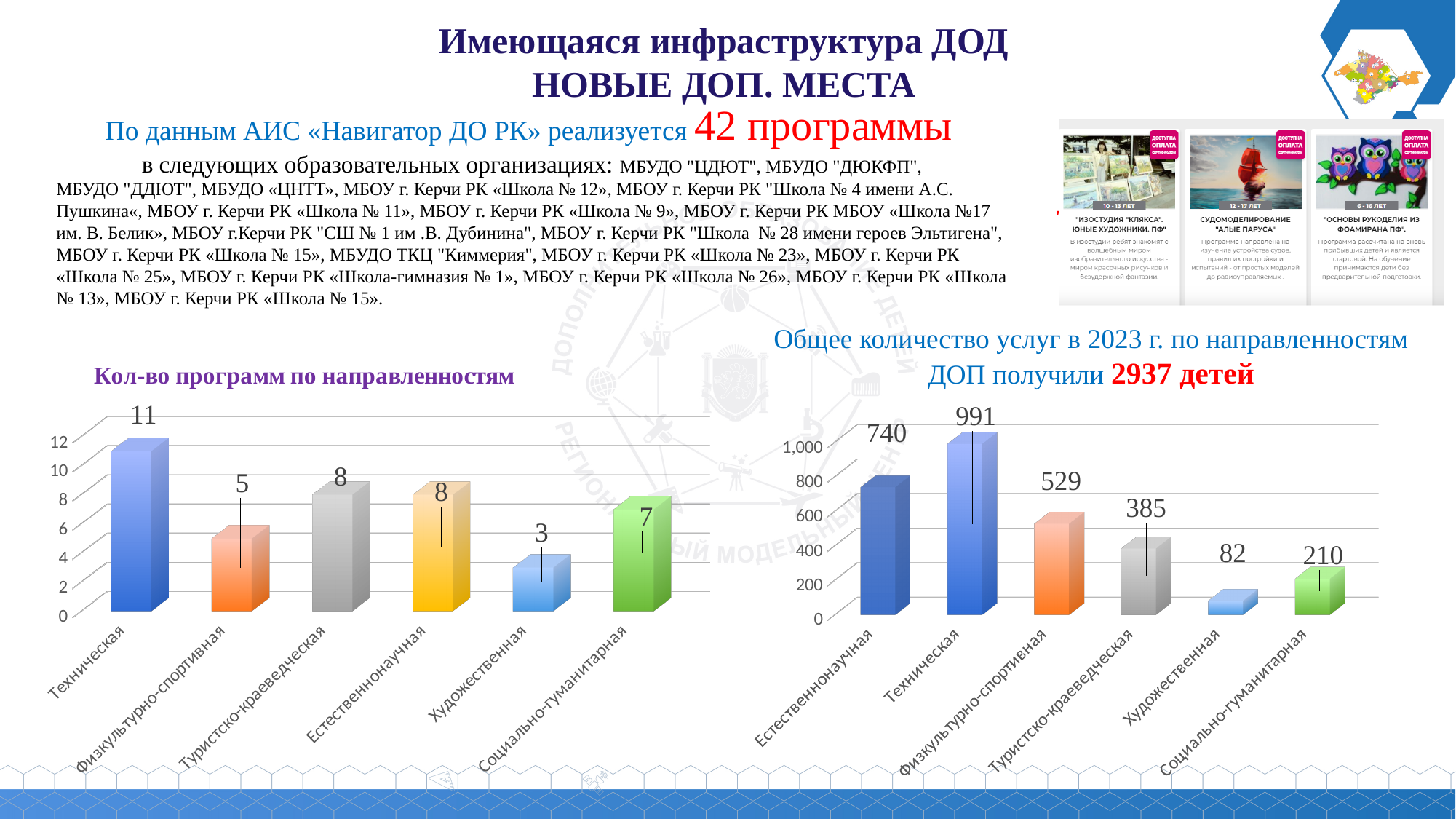
In the left chart 'Кол-во программ по направленностям', how many categories are shown? 6 In the right chart 'Общее количество услуг в 2023 г. по направленностям', which category has the highest value? Техническая In the right chart 'Общее количество услуг в 2023 г. по направленностям', which is larger: Естественнонаучная or Физкультурно-спортивная? Естественнонаучная In the right chart 'Общее количество услуг в 2023 г. по направленностям', what is the difference between Техническая and Художественная? 909 In the left chart 'Кол-во программ по направленностям', what is the difference between Техническая and Физкультурно-спортивная? 6 In the right chart 'Общее количество услуг в 2023 г. по направленностям', is the value for Социально-гуманитарная greater or less than 400? less In the right chart 'Общее количество услуг в 2023 г. по направленностям', what is the value for Техническая? 991 What type of chart is the right chart 'Общее количество услуг в 2023 г. по направленностям'? Bar chart In the right chart 'Общее количество услуг в 2023 г. по направленностям', what is the value for Туристско-краеведческая? 385 In the left chart 'Кол-во программ по направленностям', which category has the lowest value? Художественная In the left chart 'Кол-во программ по направленностям', what is the value for Техническая? 11 In the left chart 'Кол-во программ по направленностям', what is the value for Художественная? 3